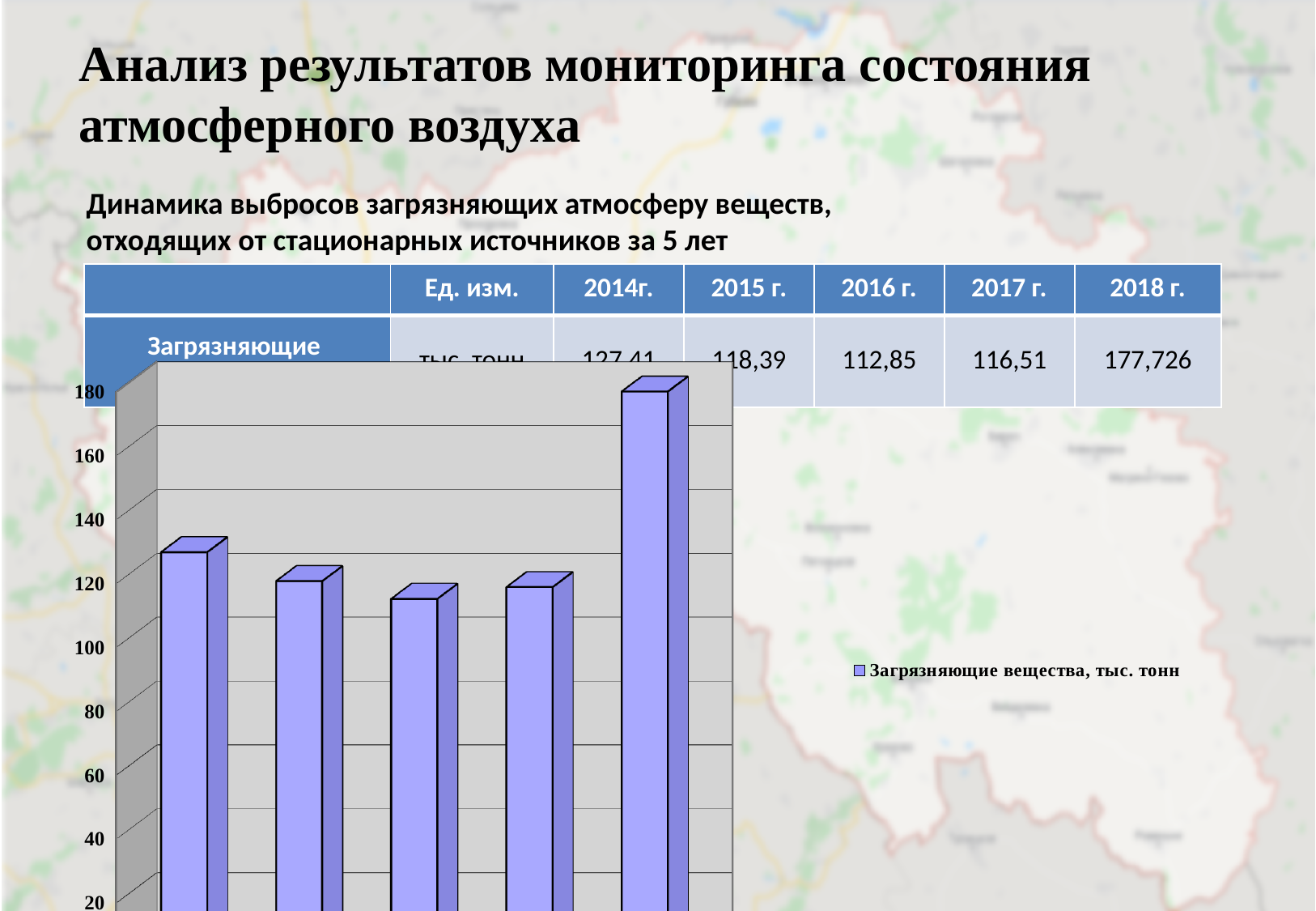
How many bars are plotted in the chart? 5 Is the value of the second bar greater or less than 100? greater Is the value of the first bar greater or less than 120? greater Is the value of the fifth bar greater or less than 160? greater What is the legend entry of the chart? Загрязняющие вещества, тыс. тонн Which is larger, the first bar or the second bar? the first bar What kind of chart is shown on the slide? bar chart Which bar in the chart is the tallest? the fifth (last) bar Does the value rise or fall from the fourth bar to the fifth bar? rise Which bar in the chart is the shortest? the third bar How many series does the chart legend list? 1